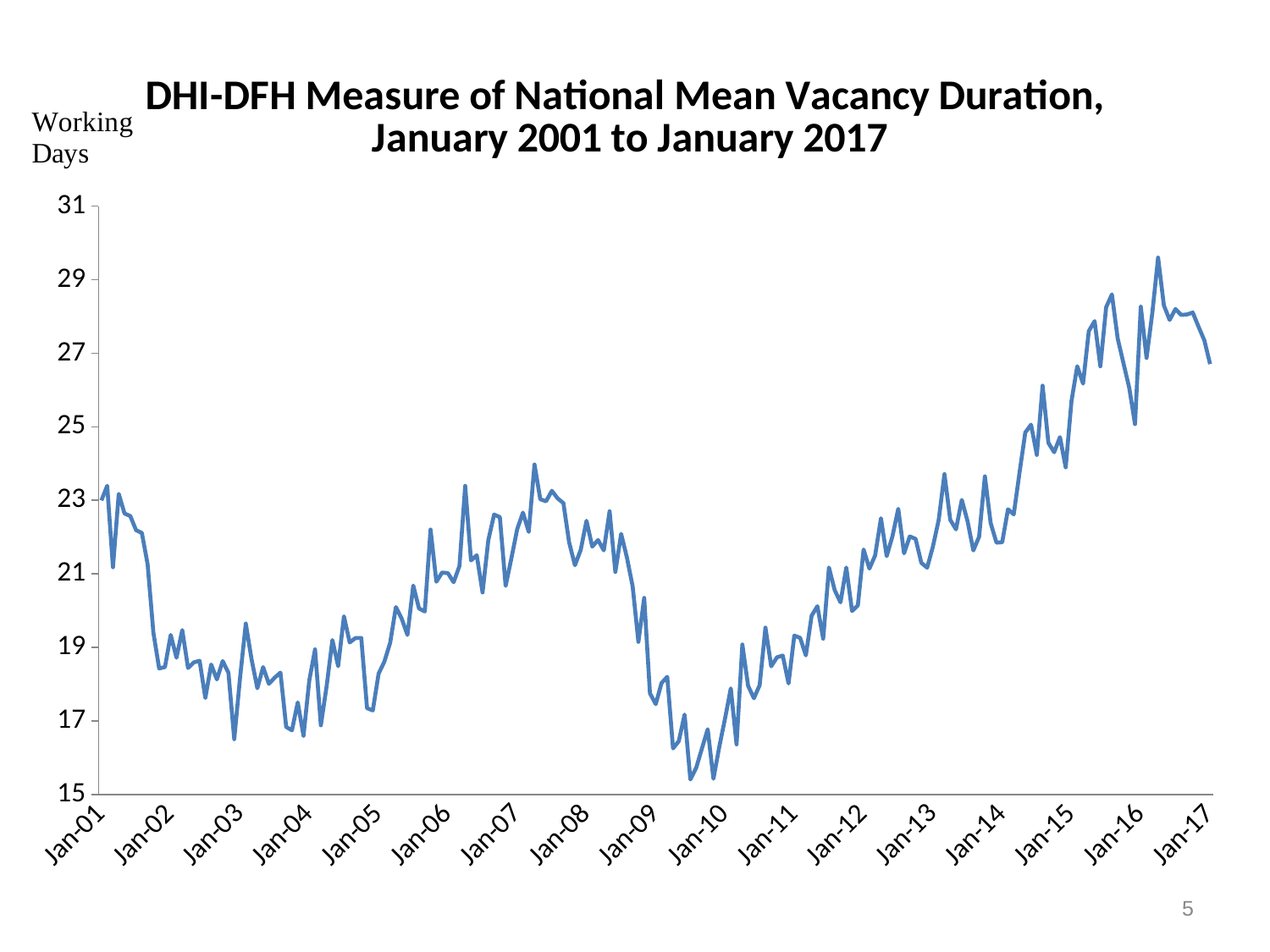
How many year labels are shown along the x axis, from Jan-01 to Jan-17? 17 What kind of chart is shown on the slide? line chart Is the value at Jan-03 greater or less than 21? less Does the line rise or fall overall between Jan-10 and Jan-15? rise Is the value at Jan-01 greater or less than 21? greater Is the highest point of the line greater or less than 27? greater How many lines (data series) are plotted on the chart? 1 What unit is the vertical axis measured in, according to the label at the top left? Working Days What is the title of the chart? DHI-DFH Measure of National Mean Vacancy Duration, January 2001 to January 2017